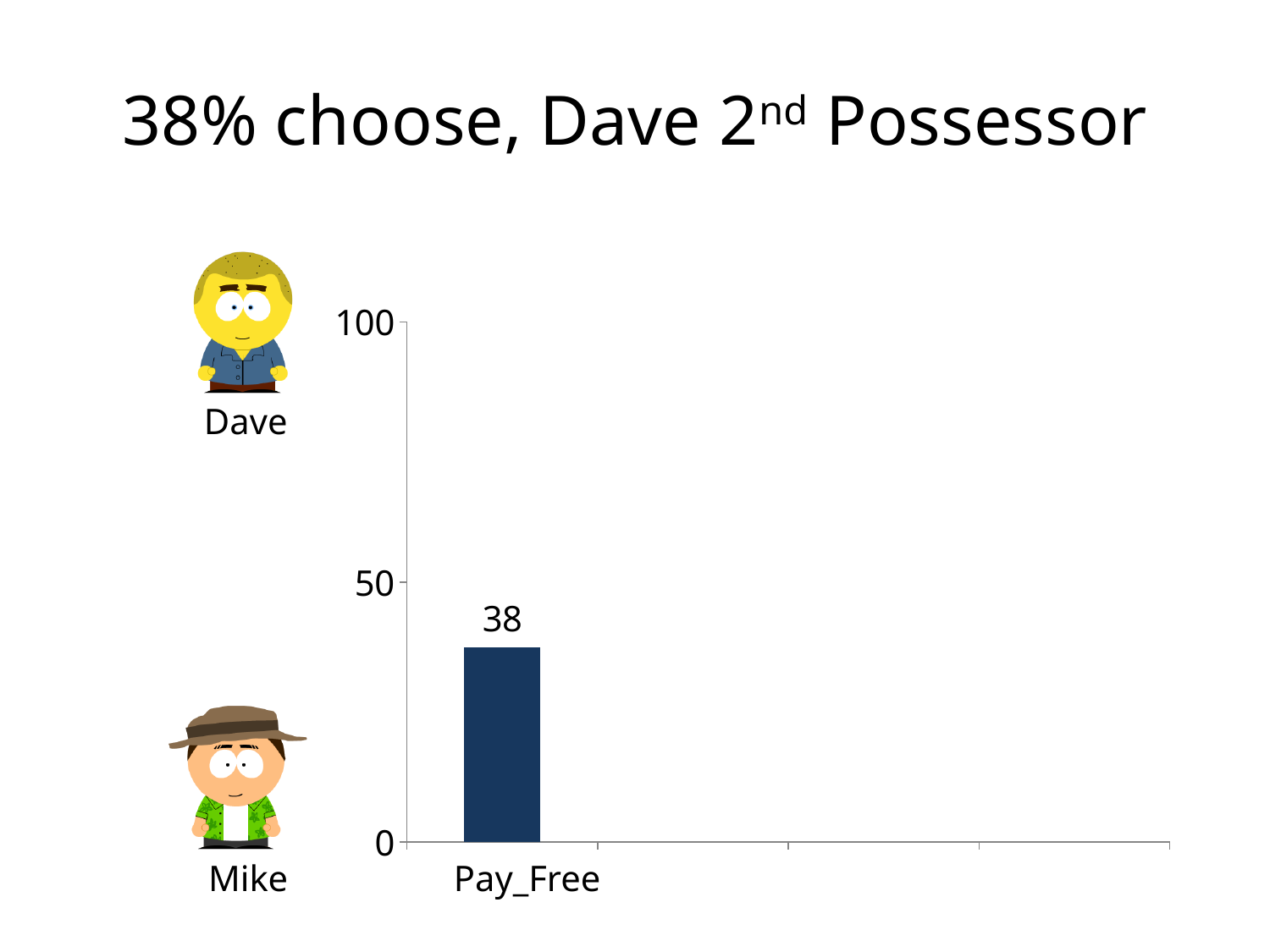
What kind of chart is shown on the slide? bar chart What is the highest value shown on the y axis? 100 What is the title of the slide containing the chart? 38% choose, Dave 2nd Possessor What is the label of the only category shown on the x axis? Pay_Free Is the value for Pay_Free greater or less than 50? less Is the value for Pay_Free greater or less than 0? greater How many bars are plotted in the chart? 1 What is the value of the Pay_Free bar? 38